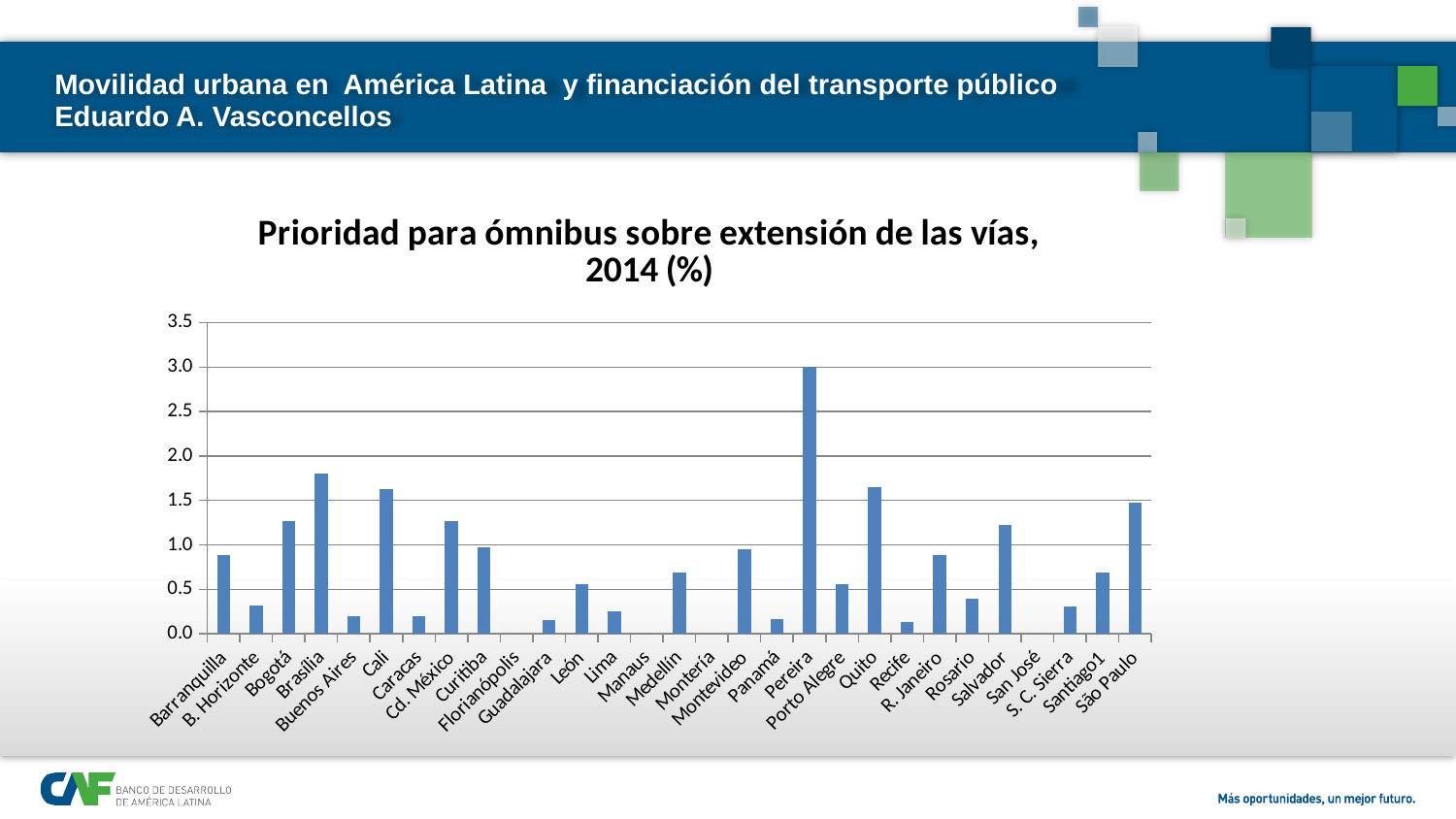
Which has a larger value, Brasilia or Bogotá? Brasilia Is the value for Lima greater or less than 0.5? less Which has a larger value, Pereira or Quito? Pereira What is the title of the chart? Prioridad para ómnibus sobre extensión de las vías, 2014 (%) Is the value for Brasilia greater or less than 1.5? greater Is the value for Buenos Aires greater or less than 0.5? less Which city has the highest value in the chart? Pereira What is the maximum value shown on the vertical axis of the chart? 3.5 How many cities are shown on the x axis of the chart? 29 What kind of chart is shown on the slide? bar chart